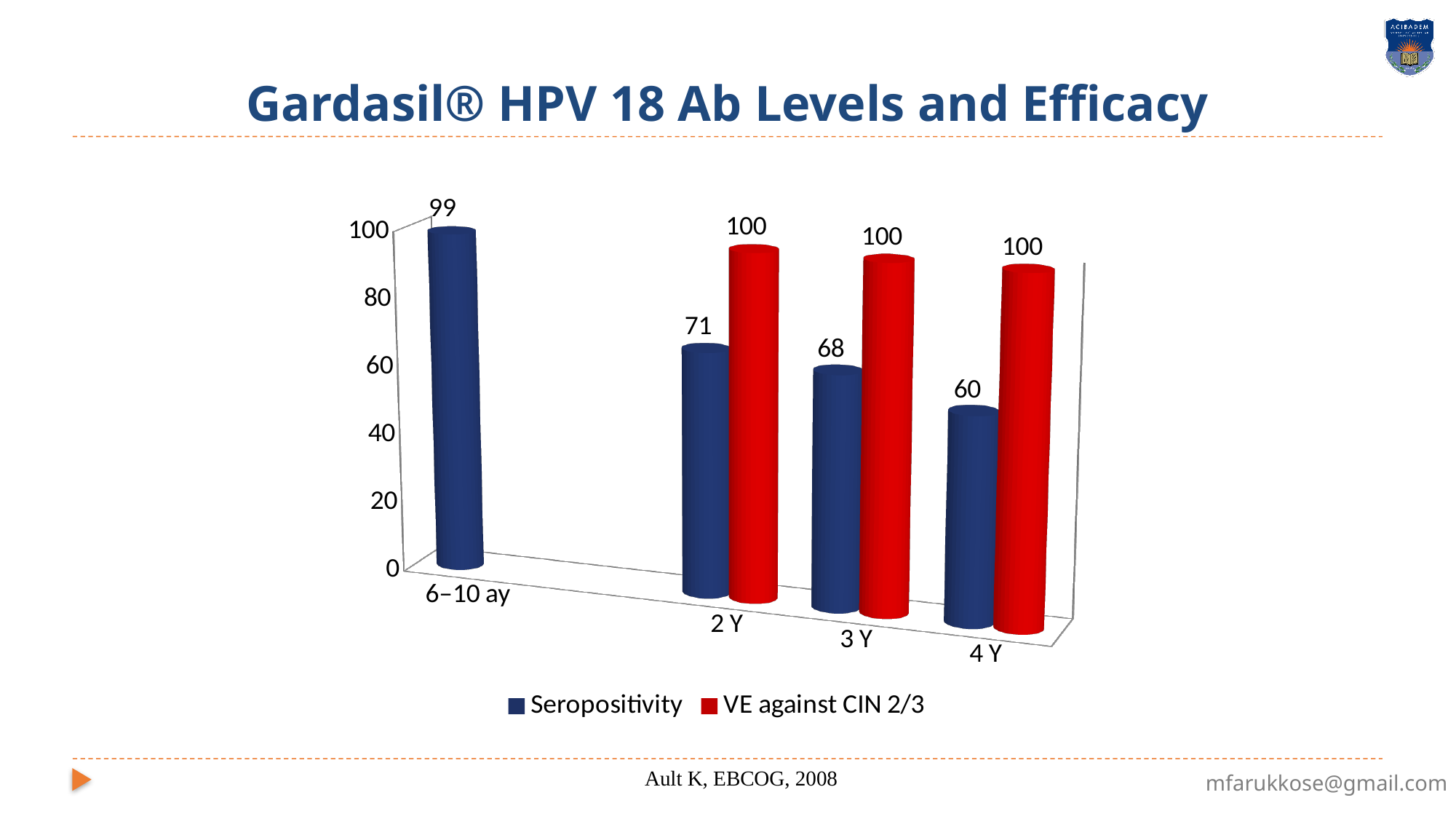
What kind of chart is shown on the slide? Bar chart Does the Seropositivity value rise or fall from 2 Y to 4 Y? Fall Which category has the highest Seropositivity value? 6–10 ay How many categories are shown on the x axis? 4 How many series does the legend list? 2 What is the difference between the VE against CIN 2/3 value and the Seropositivity value at 3 Y? 32 What is the Seropositivity value for the 6–10 ay category? 99 What is the Seropositivity value at 4 Y? 60 What is the VE against CIN 2/3 value at 3 Y? 100 What is the Seropositivity value at 2 Y? 71 Which is larger at 2 Y: Seropositivity or VE against CIN 2/3? VE against CIN 2/3 Which category has the lowest Seropositivity value? 4 Y